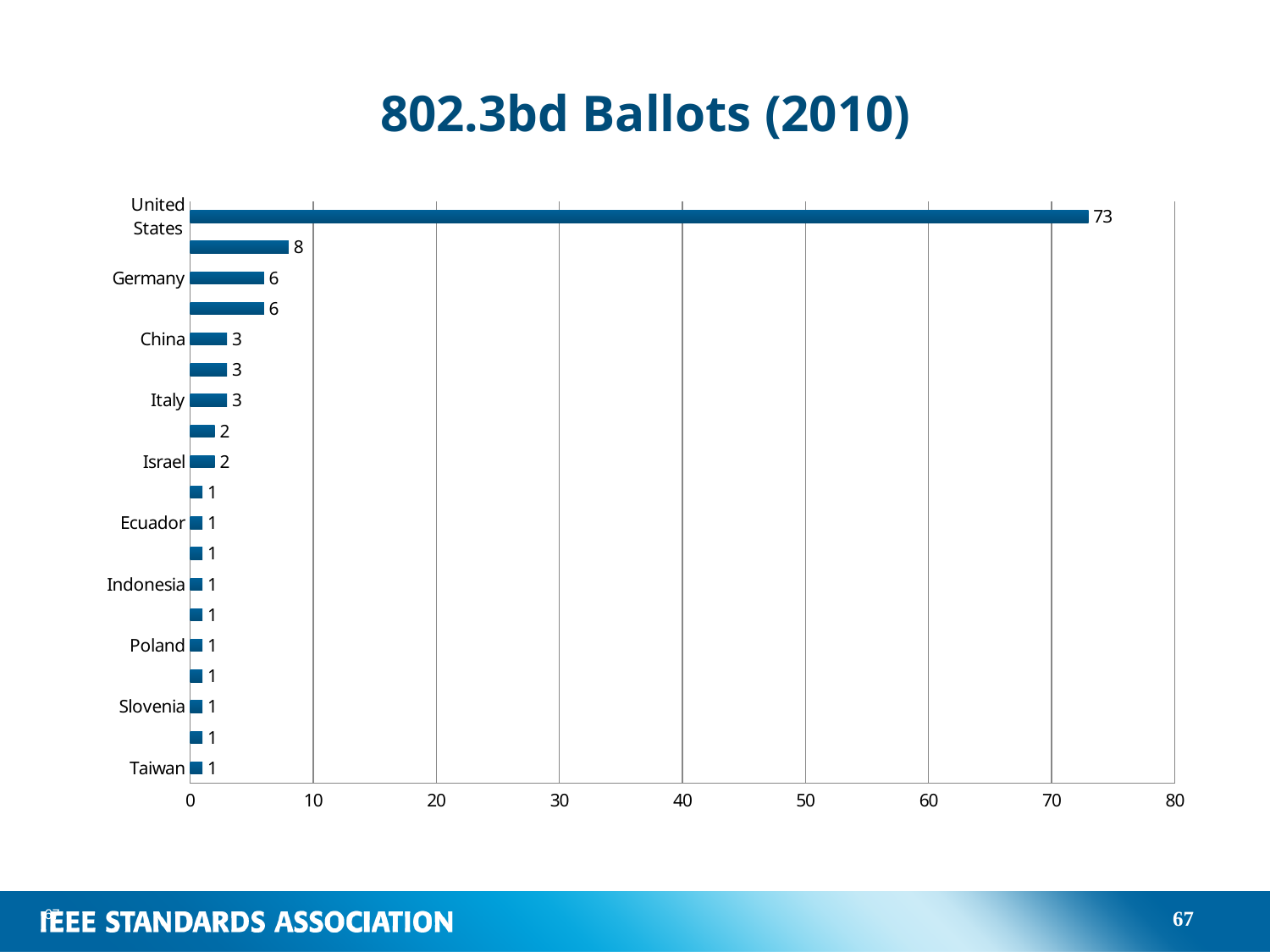
Is the value for United States greater or less than 70? greater Which is larger, the value for Germany or the value for China? Germany What is the value for China? 3 What is the value for Israel? 2 What is the value for United States? 73 What is the value for Germany? 6 What is the value for Taiwan? 1 What kind of chart is shown on the slide? bar chart What is the difference between the values for United States and Germany? 67 How many bars are plotted in the chart? 19 What is the title of the chart? 802.3bd Ballots (2010) Which category has the highest value? United States